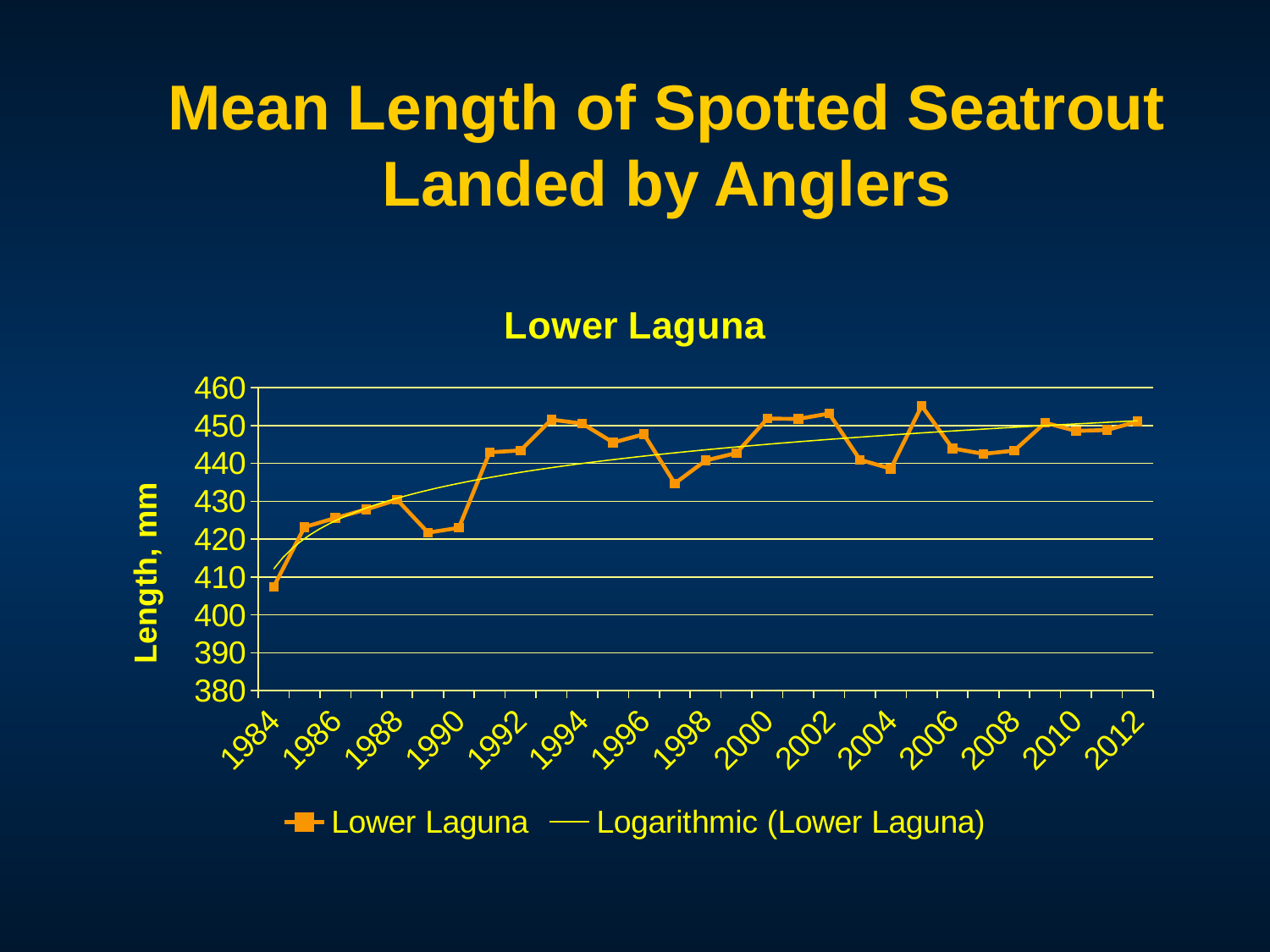
Is the value for 1997 greater or less than 440? less What is the label of the vertical axis? Length, mm How many entries does the legend list? 2 Is the value for 1989 greater or less than 430? less Which year has the larger mean length, 1993 or 1997? 1993 Which year has the lowest mean length in the Lower Laguna series? 1984 What kind of chart is shown on the slide? line chart Which year has the larger mean length, 1984 or 2012? 2012 What is the title of the chart? Lower Laguna Is the value for 2005 greater or less than 450? greater Overall, does the mean length rise or fall from 1984 to 2012? rise